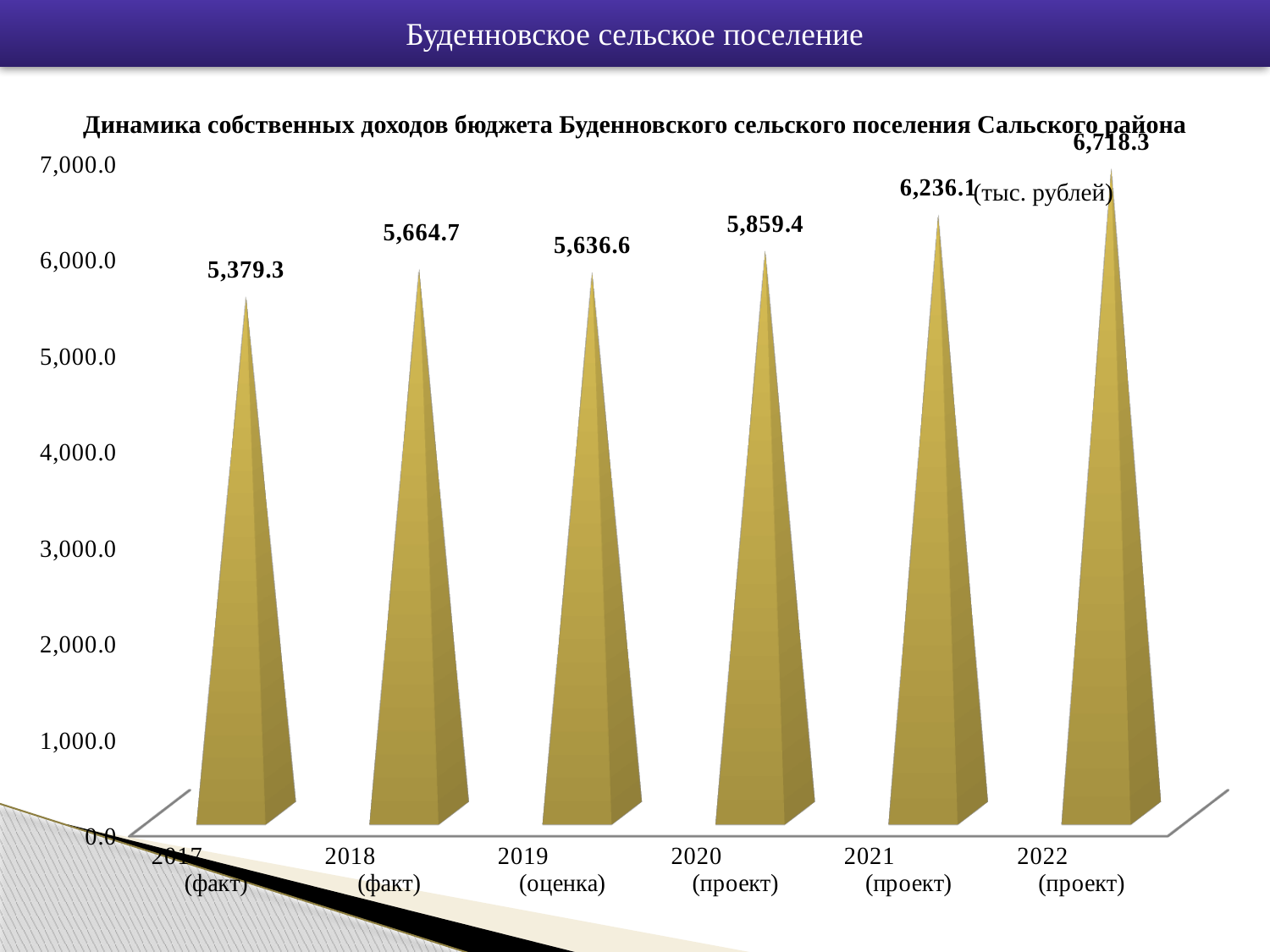
What is the value for 2021 (проект)? 6,236.1 What kind of chart is shown on the slide? bar chart How many years are shown on the x axis? 6 What is the difference between the values for 2022 (проект) and 2021 (проект)? 482.2 Which is larger, the value for 2018 (факт) or the value for 2019 (оценка)? 2018 (факт) What is the value for 2019 (оценка)? 5,636.6 Which year has the lowest value? 2017 (факт) What is the value for 2017 (факт)? 5,379.3 Which year has the highest value? 2022 (проект) Do the values rise or fall from 2019 to 2022? rise Is the value for 2020 (проект) greater or less than 6,000.0? less What is the difference between the values for 2018 (факт) and 2017 (факт)? 285.4